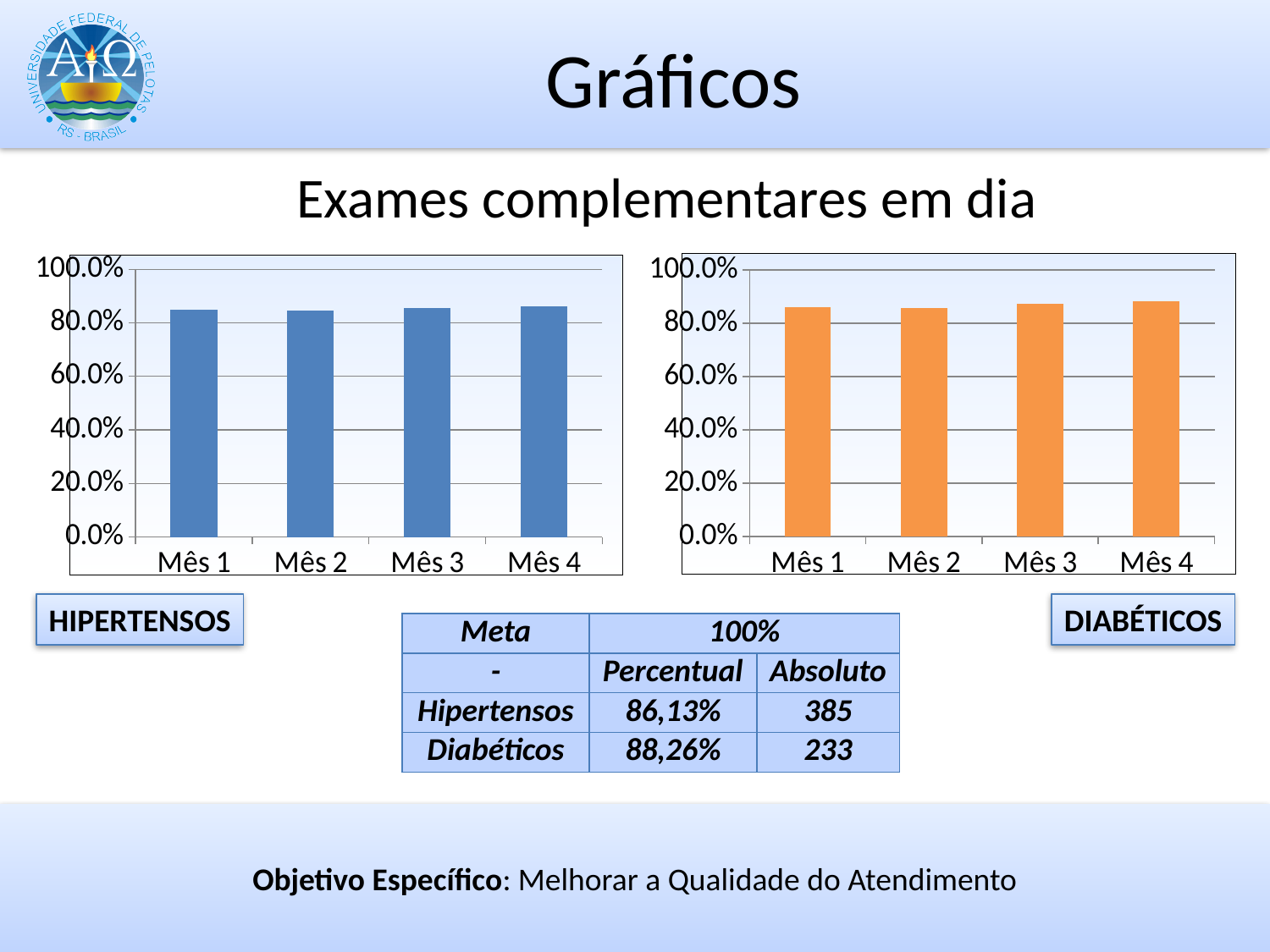
How many categories (months) are shown on the HIPERTENSOS chart? 4 On the HIPERTENSOS chart, is the value for Mês 3 greater or less than 60.0%? greater What kind of chart is the DIABÉTICOS chart on the right? bar chart On the DIABÉTICOS chart, is the value for Mês 4 greater or less than 100.0%? less What kind of chart is the HIPERTENSOS chart on the left? bar chart On the HIPERTENSOS chart, is the value for Mês 1 greater or less than 80.0%? greater What colour are the bars on the DIABÉTICOS chart? orange What is the label of the first category on the x axis of the DIABÉTICOS chart? Mês 1 How many bars are plotted on the DIABÉTICOS chart? 4